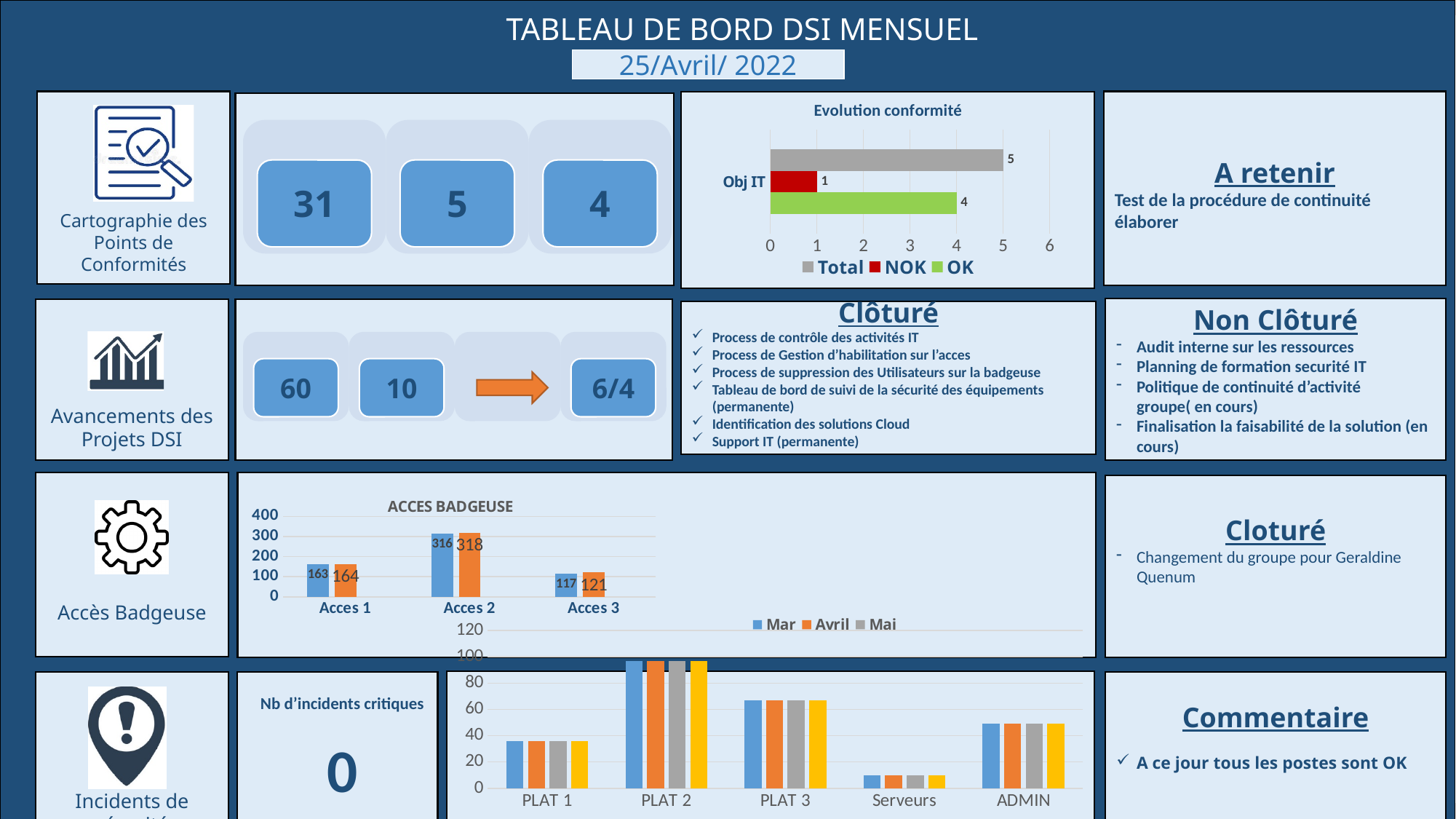
In the 'ACCES BADGEUSE' chart, what is the difference between the Avril and Mar values for Acces 2? 2 In the bottom chart (PLAT 1 to ADMIN), how many categories are shown on the x axis? 5 In the 'ACCES BADGEUSE' chart, what is the Avril value for Acces 3? 121 In the bottom chart (PLAT 1 to ADMIN), are the values for Serveurs greater or less than 20? less In the 'Evolution conformité' chart, what is the value of the NOK bar? 1 What kind of chart is 'Evolution conformité'? Bar chart In the 'Evolution conformité' chart, what is the difference between the Total and OK values? 1 How many series does the legend of the 'ACCES BADGEUSE' chart list? 3 In the 'ACCES BADGEUSE' chart, which category has the highest values? Acces 2 How many series does the legend of the 'Evolution conformité' chart list? 3 In the 'ACCES BADGEUSE' chart, what is the Mar value for Acces 2? 316 In the 'Evolution conformité' chart, what is the value of the Total bar? 5